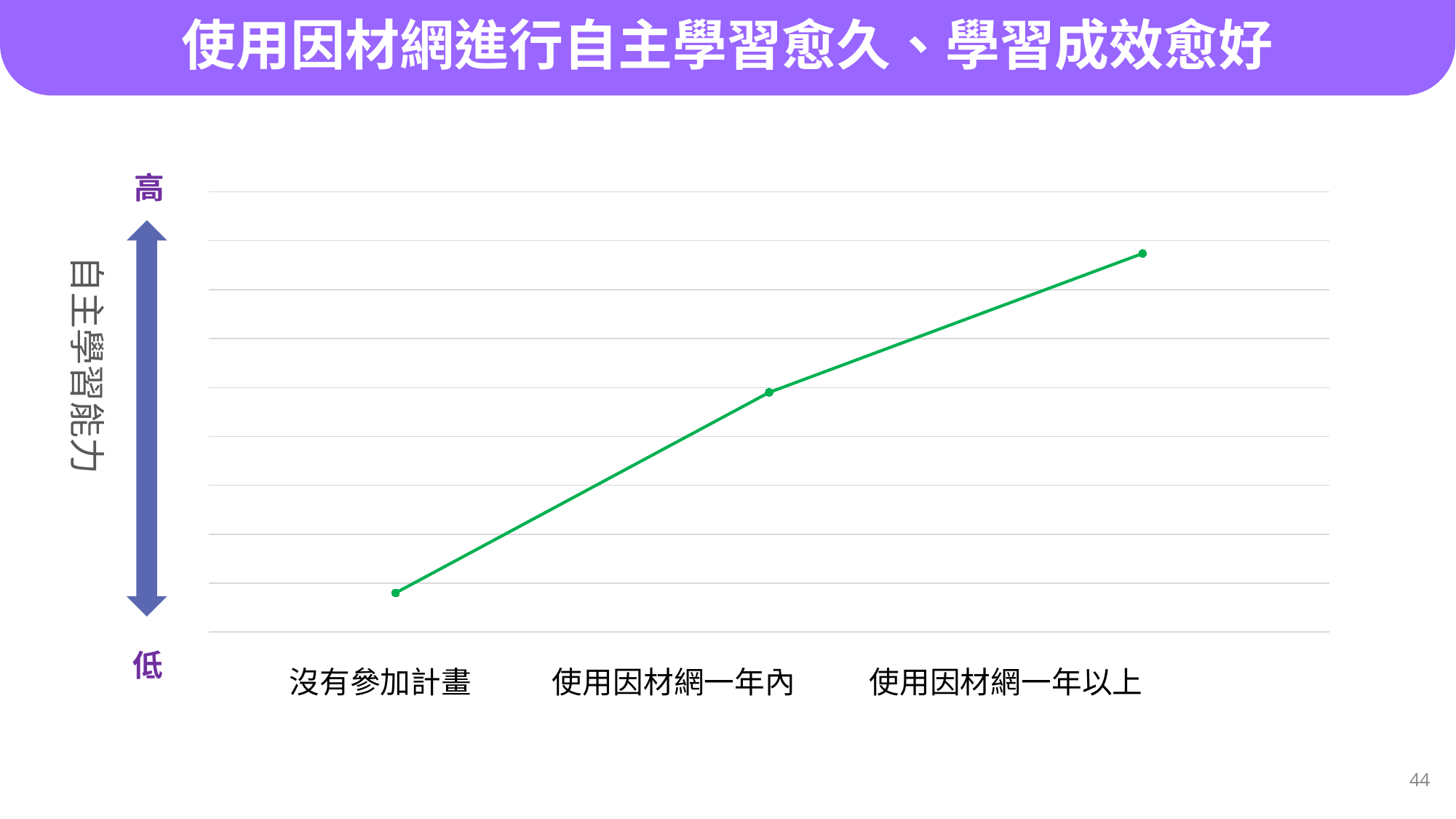
How many data points are plotted on the line? 3 How many categories are shown on the x axis? 3 Do the values rise or fall from left to right along the x axis? rise What is the title of the slide above the chart? 使用因材網進行自主學習愈久、學習成效愈好 What is the label of the first category on the x axis? 沒有參加計畫 What kind of chart is shown on the slide? line chart Which is larger, the value for 使用因材網一年內 or the value for 沒有參加計畫? 使用因材網一年內 Which is larger, the value for 使用因材網一年以上 or the value for 使用因材網一年內? 使用因材網一年以上 What is the label of the last category on the x axis? 使用因材網一年以上 What is the label of the vertical axis? 自主學習能力 Which category has the lowest value? 沒有參加計畫 Which category has the highest value? 使用因材網一年以上